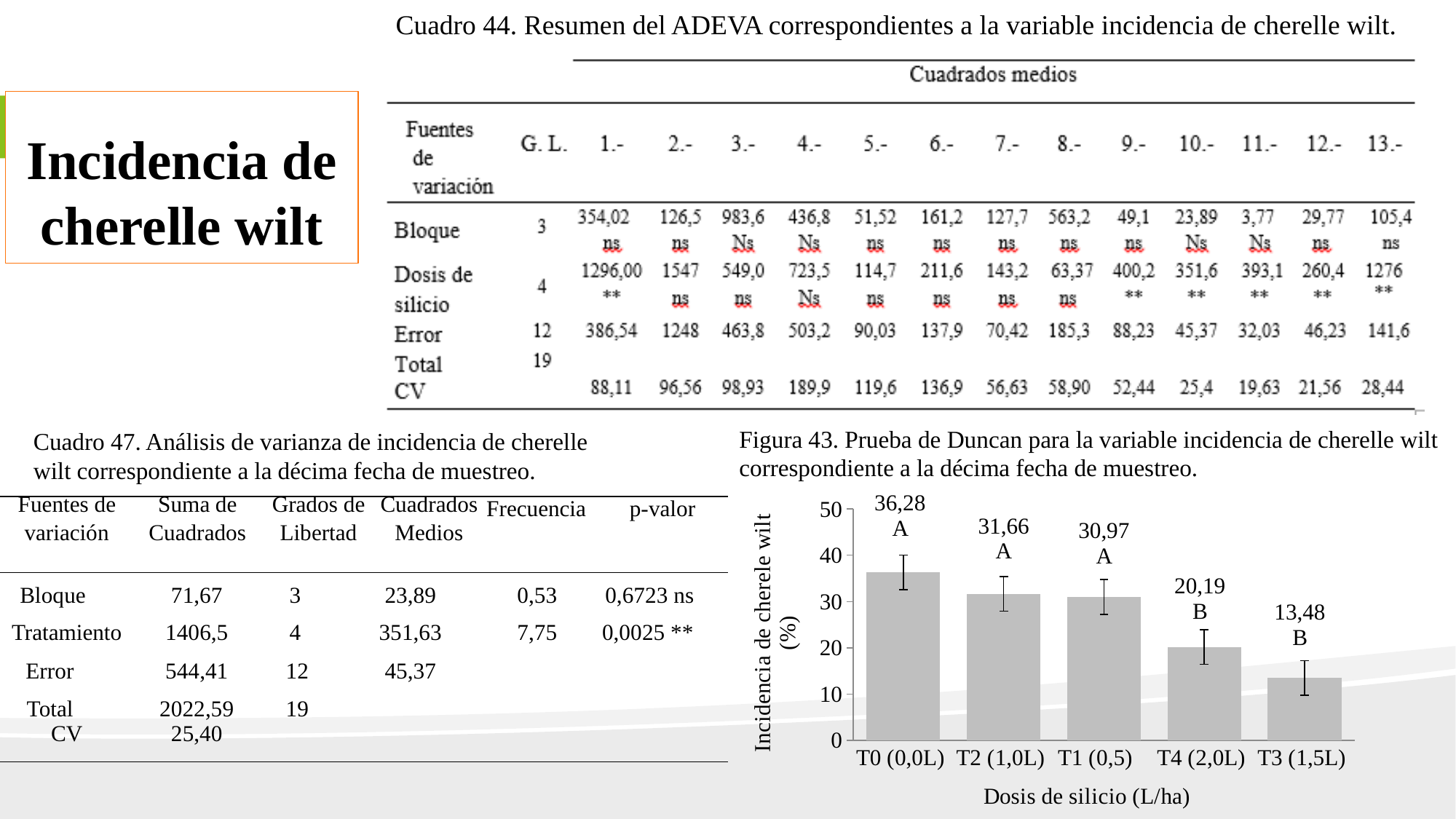
In Figura 43, what is the value for T3 (1,5L)? 13,48 What is the y-axis label of the chart in Figura 43? Incidencia de cherele wilt (%) In Figura 43, which dose has the lowest incidence of cherelle wilt? T3 (1,5L) In Figura 43, what is the difference between the values for T0 (0,0L) and T3 (1,5L)? 22,80 In Figura 43, what is the value for T4 (2,0L)? 20,19 What kind of chart is Figura 43? bar chart In Figura 43, is the value for T1 (0,5) greater or less than 30? greater In Figura 43, what is the difference between the values for T4 (2,0L) and T3 (1,5L)? 6,71 How many bars are shown in Figura 43? 5 In Figura 43, which is larger, the value for T2 (1,0L) or the value for T4 (2,0L)? T2 (1,0L) In Figura 43, what is the value for T0 (0,0L)? 36,28 In Figura 43, which dose has the highest incidence of cherelle wilt? T0 (0,0L)